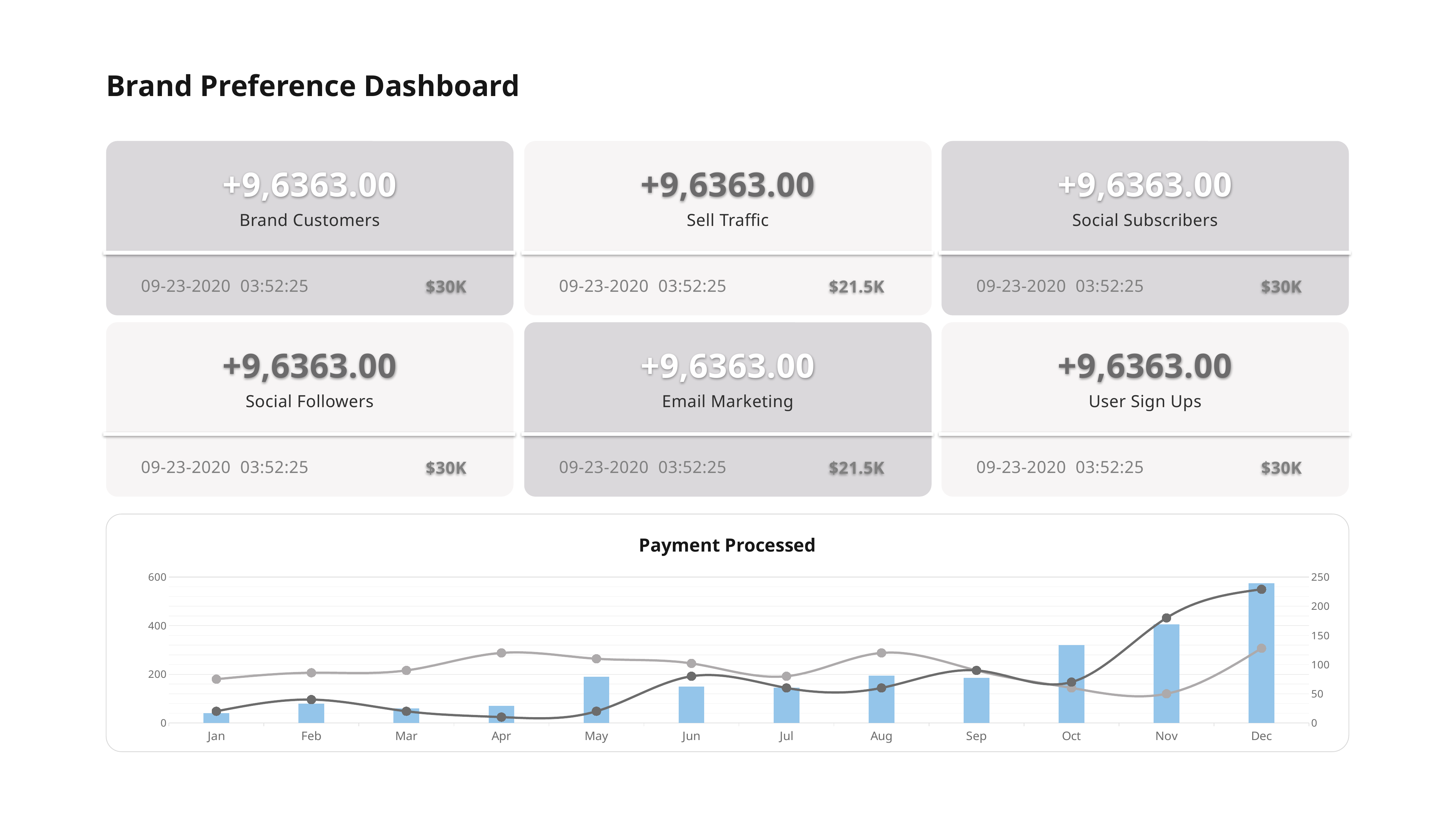
In the Payment Processed chart, in which month does the dark grey line reach its highest point? Dec In the Payment Processed chart, is the bar for Jan greater or less than 200 on the left axis? less In the Payment Processed chart, is the bar for Oct greater or less than 200 on the left axis? greater What is the title of the chart at the bottom of the slide? Payment Processed In the Payment Processed chart, do the bars generally rise or fall from Jan to Dec? Rise In the Payment Processed chart, which bar is taller, Jan or Nov? Nov How many months are shown on the x axis of the Payment Processed chart? 12 In the Payment Processed chart, which month has the tallest bar? Dec In the Payment Processed chart, which bar is taller, Oct or Sep? Oct What kind of chart is the Payment Processed chart? A combined bar and line chart In the Payment Processed chart, is the bar for May greater or less than 400 on the left axis? less